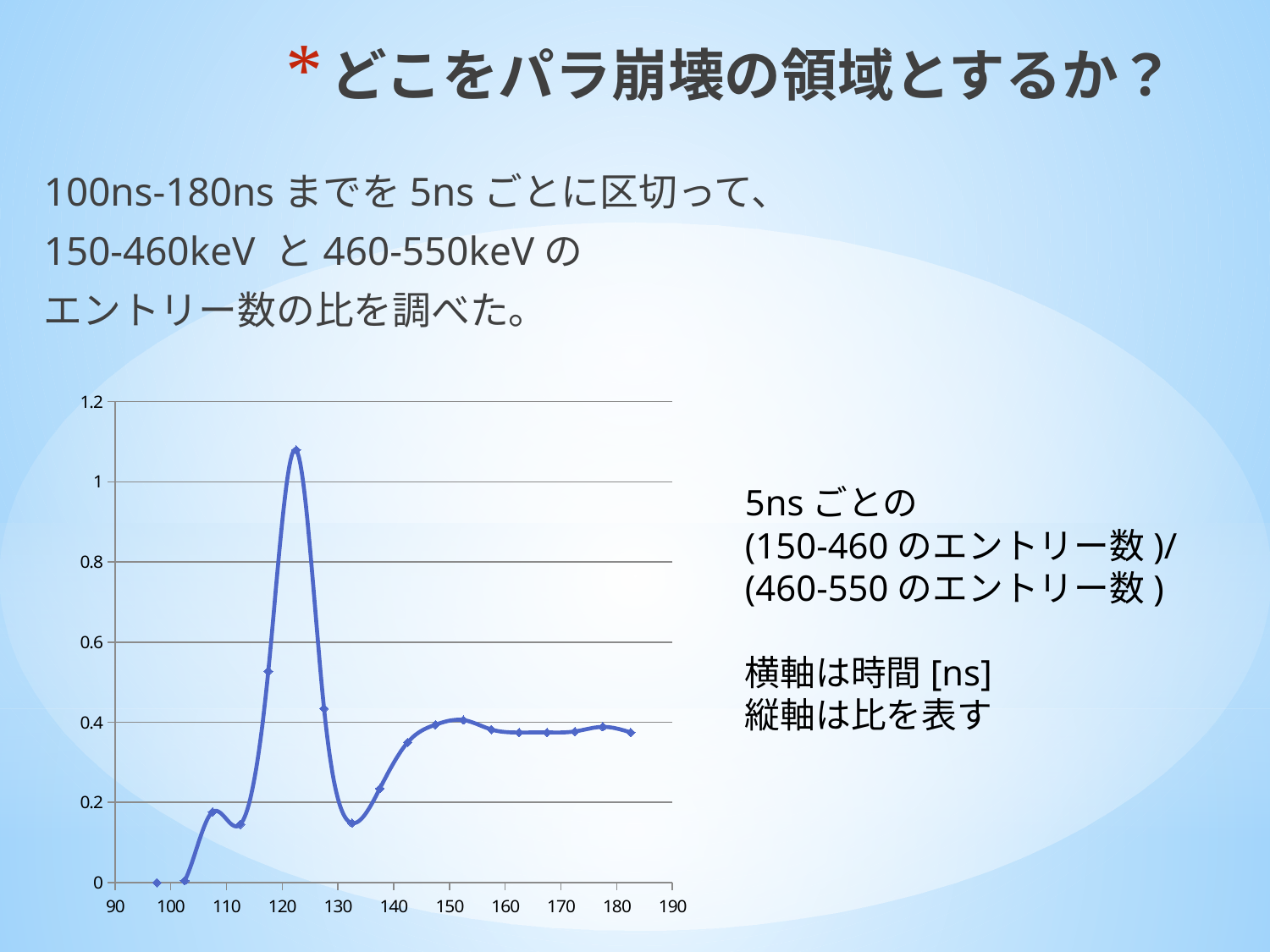
How many lines (series) are plotted on the chart? 1 What is the highest tick label shown on the y axis? 1.2 Is the value of the point just after 130 on the x axis greater or less than 0.2? less Is the highest value on the line greater or less than 1? greater Is the value of the point just before 120 on the x axis greater or less than 0.4? greater Between which two x-axis tick labels does the peak of the line occur? 120 and 130 Do the values rise or fall along the x axis between 110 and 120? rise What kind of chart is shown on the slide? line chart Do the values rise or fall along the x axis between 125 and 135? fall